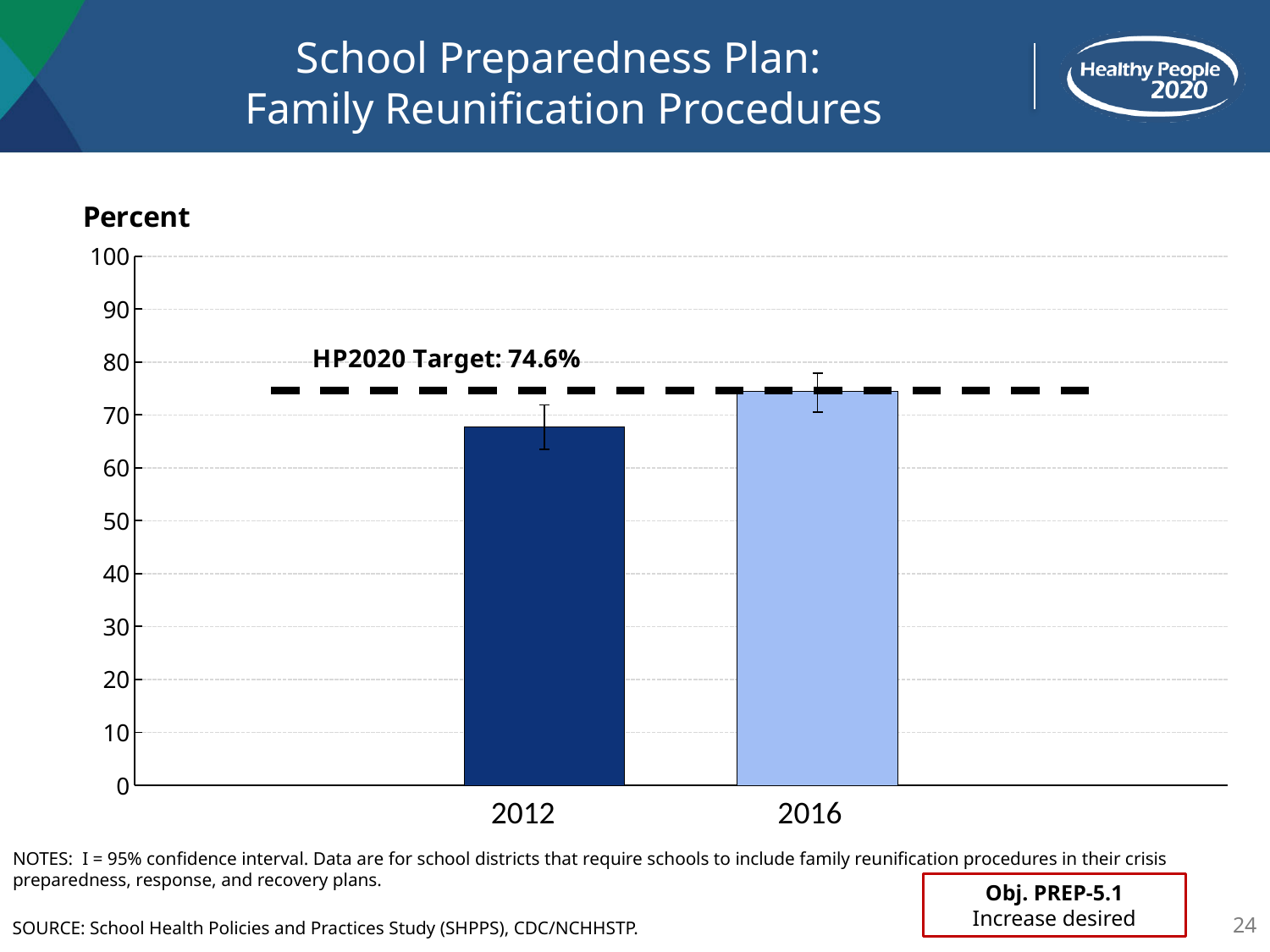
What is the HP2020 target value shown by the dashed line on the chart? 74.6% Is the value for 2016 greater or less than 80? less Is the value for 2016 greater or less than 70? greater How many years (bars) are plotted in the chart? 2 Is the value for 2012 greater or less than 70? less Does the value rise or fall from 2012 to 2016? rise Is the value for 2016 larger or smaller than the value for 2012? larger Which year has the higher value in the chart? 2016 Which year has the lower value in the chart? 2012 What kind of chart is shown on the slide? bar chart What is the label of the vertical axis of the chart? Percent